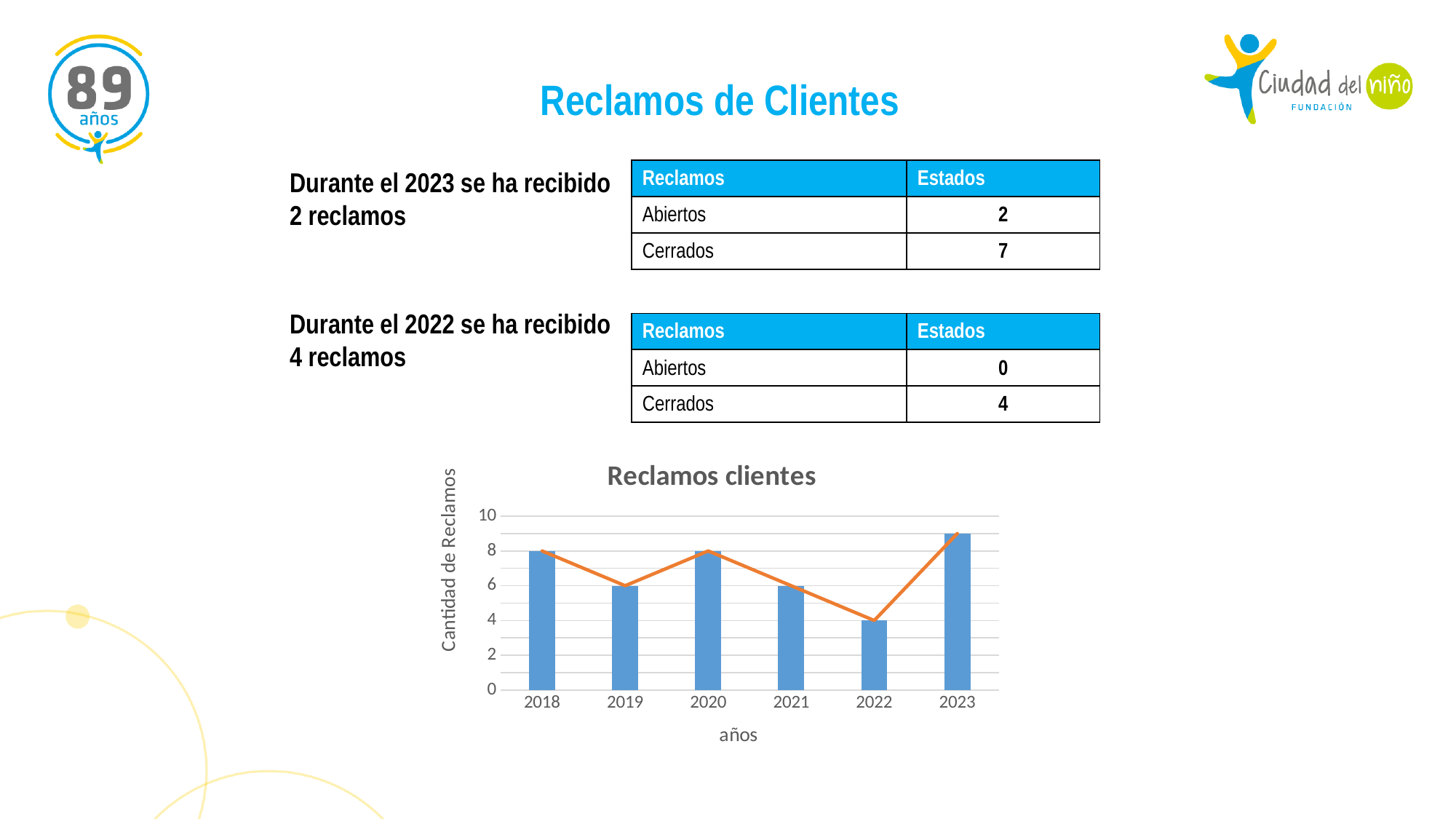
What is the value for 2019 in the 'Reclamos clientes' chart? 6 Which year has the lowest value in the 'Reclamos clientes' chart? 2022 In the 'Reclamos clientes' chart, which year has the larger value, 2018 or 2022? 2018 How many years are shown on the x axis of the 'Reclamos clientes' chart? 6 In the 'Reclamos clientes' chart, do the values rise or fall from 2020 to 2022? fall What is the value for 2018 in the 'Reclamos clientes' chart? 8 What is the y-axis label of the 'Reclamos clientes' chart? Cantidad de Reclamos Which year has the highest value in the 'Reclamos clientes' chart? 2023 In the 'Reclamos clientes' chart, what is the difference between the values for 2018 and 2022? 4 What kind of chart is the 'Reclamos clientes' chart? combination bar and line chart Is the value for 2023 in the 'Reclamos clientes' chart greater or less than 8? greater What is the value for 2022 in the 'Reclamos clientes' chart? 4